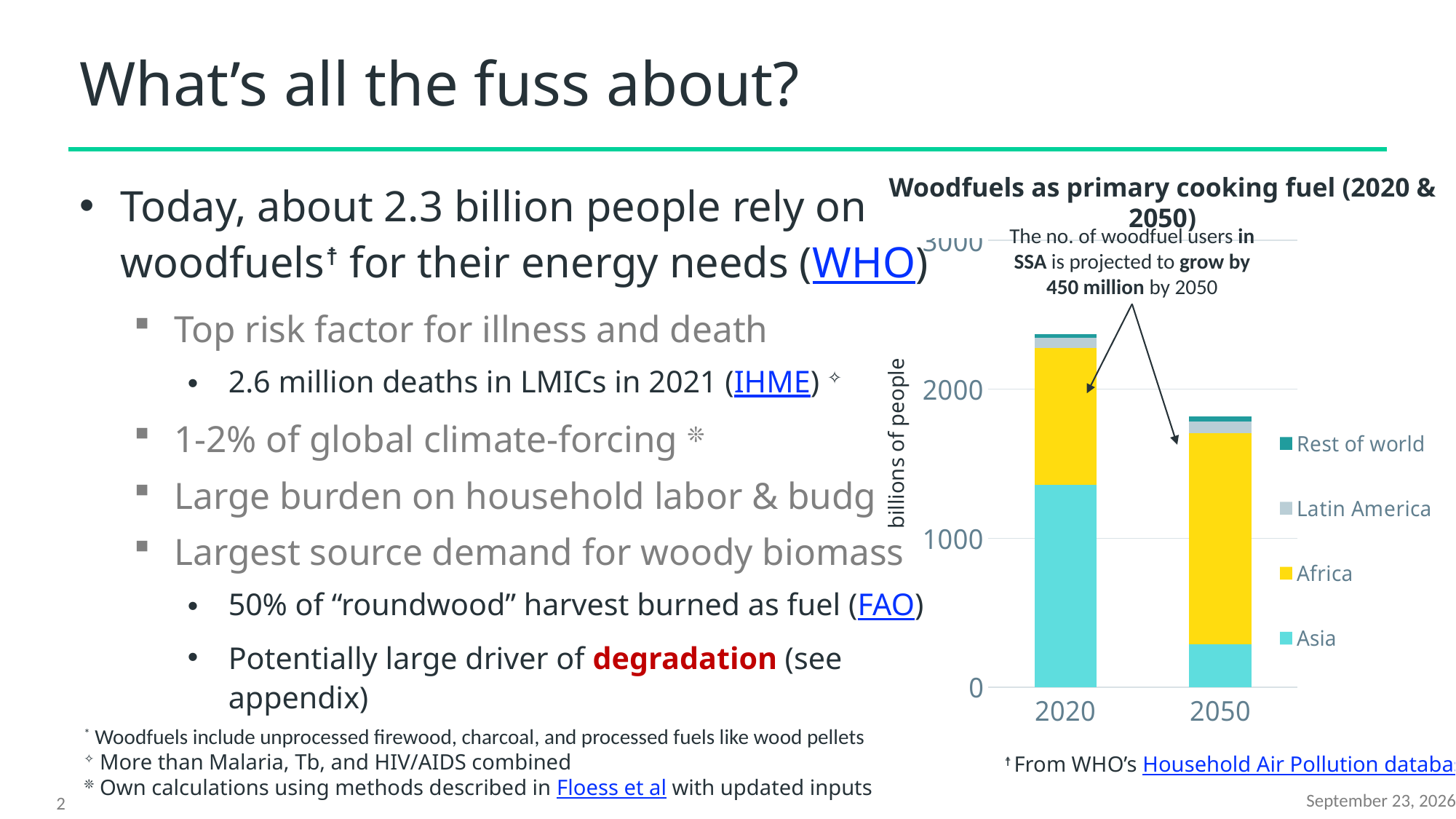
What is the label of the chart's vertical axis? billions of people Is the value for Asia in 2050 greater or less than 1000? less Is the total height of the 2050 bar greater or less than 2000? less Is the total height of the 2020 bar greater or less than 2000? greater What kind of chart is shown on the slide? stacked bar chart How many series does the chart's legend list? 4 Which is larger, the Africa segment in 2020 or the Africa segment in 2050? 2050 Which is larger, the Asia segment in 2020 or the Asia segment in 2050? 2020 How many bars (years) are plotted in the chart? 2 What is the title of the chart? Woodfuels as primary cooking fuel (2020 & 2050) Does the total number of woodfuel users rise or fall from 2020 to 2050? fall